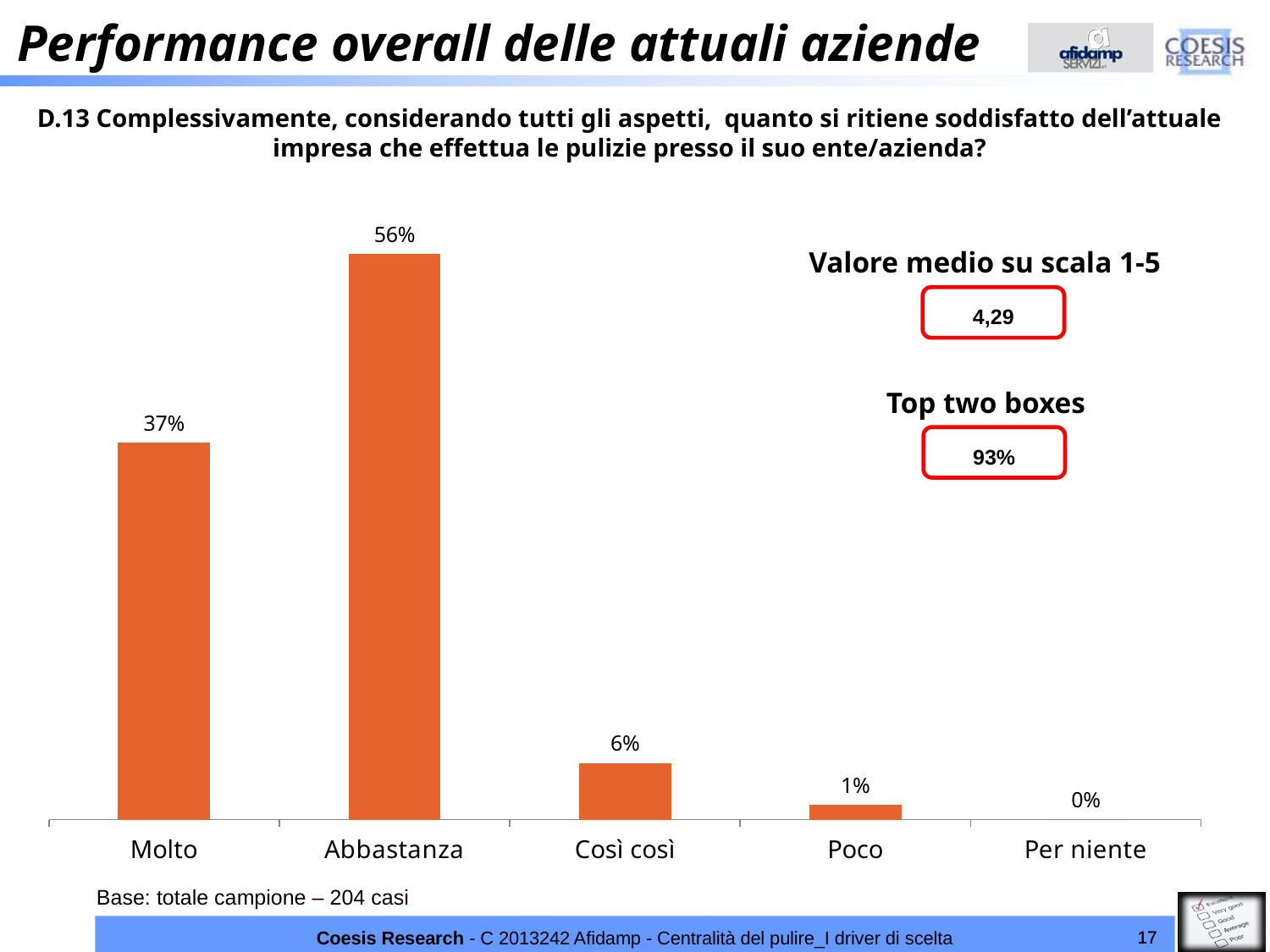
How many categories are shown on the x axis? 5 What is the value for Molto? 37% Which category has the highest value? Abbastanza Which category has the lowest value? Per niente What is the difference between the values for Abbastanza and Molto? 19% What is the value for Abbastanza? 56% What is the value for Per niente? 0% What kind of chart is shown on the slide? Bar chart What is the 'Valore medio su scala 1-5' shown next to the chart? 4,29 What is the value for Poco? 1% Which is larger, the value for Molto or the value for Così così? Molto What is the value for Così così? 6%